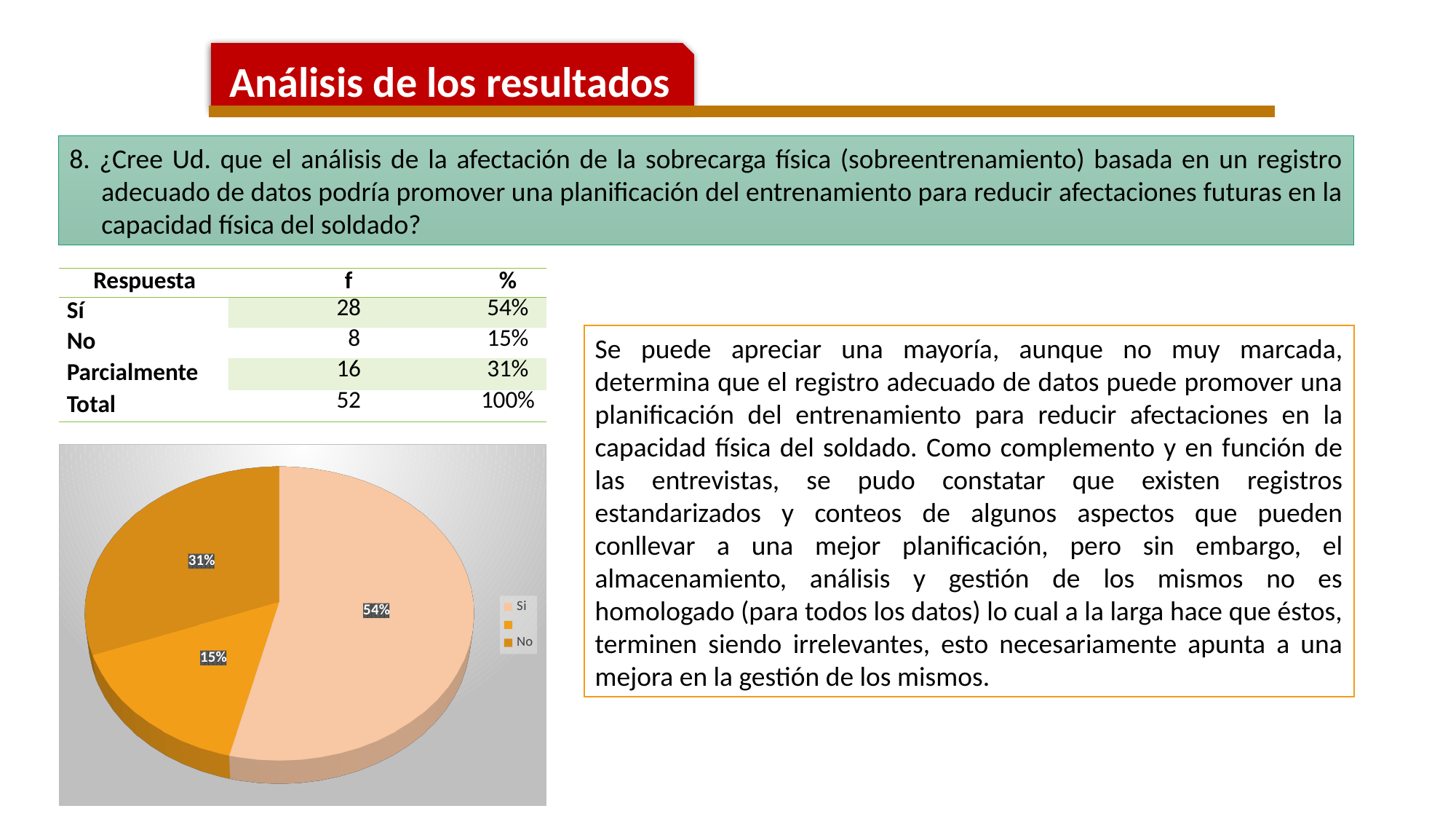
How many slices does the pie chart have? 3 What do the three slice labels of the pie chart add up to? 100% What share of the pie does the Si slice represent? 54% What is the difference in percentage points between the largest and smallest slices of the pie chart? 39 What is the difference in percentage points between the 54% slice and the 31% slice? 23 Which legend entry corresponds to the lightest-coloured slice of the pie chart? Si Is the Si slice of the pie chart greater or less than 50%? greater What percentage is shown for the Si slice of the pie chart? 54% Which is larger in the pie chart: the Si slice or the slice labelled 31%? Si What is the value of the largest slice in the pie chart? 54% What kind of chart is shown on the slide? pie chart What is the value of the smallest slice in the pie chart? 15%